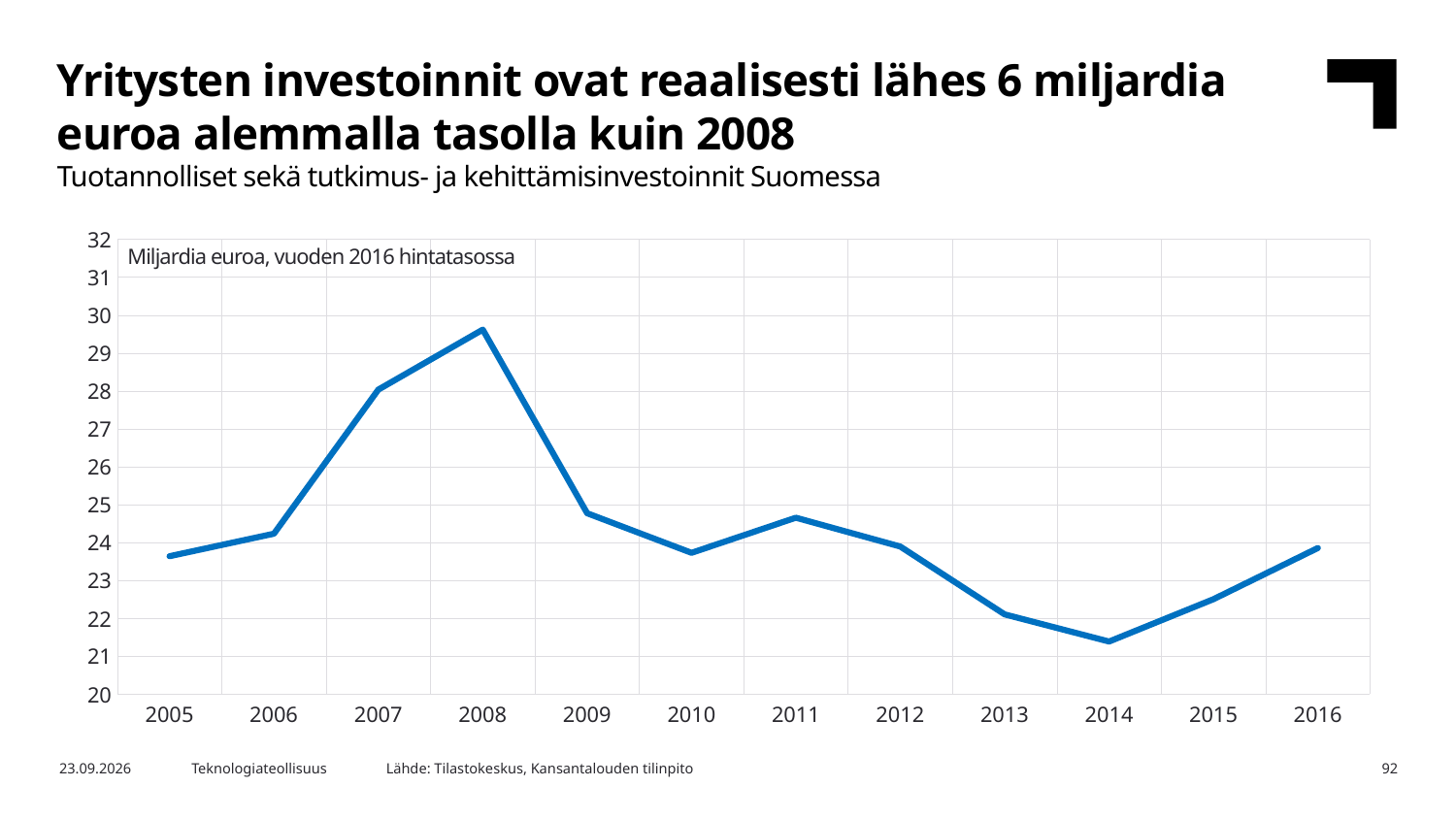
Which year has the lowest value of investments? 2014 How many years are plotted on the x axis? 12 Do the values rise or fall from 2008 to 2010? fall Which year has the larger value, 2007 or 2010? 2007 What unit is stated in the label inside the chart area? Miljardia euroa, vuoden 2016 hintatasossa Is the value for 2014 greater or less than 22? less What kind of chart is shown on the slide? line chart Is the value for 2008 greater or less than 29? greater Is the value for 2013 greater or less than 23? less Which year has the larger value, 2006 or 2014? 2006 Which year has the highest value of investments? 2008